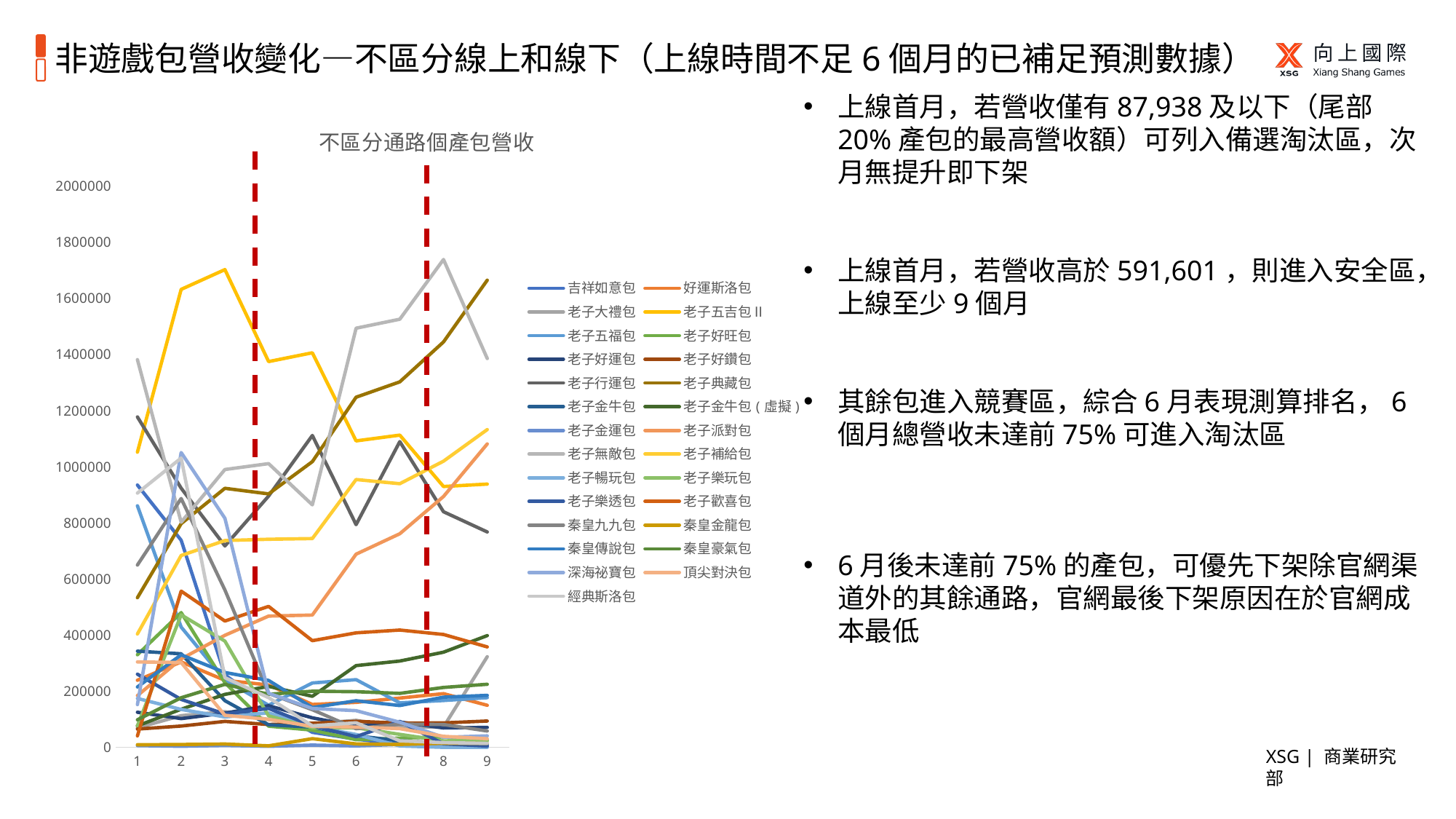
Is the highest value plotted at month 3 greater or less than 1600000? greater How many points are on the x axis of the chart? 9 How many series does the chart's legend list? 27 What is the maximum value shown on the chart's y axis? 2000000 Is the highest value plotted at month 9 greater or less than 1400000? greater Is the highest value plotted at month 5 greater or less than 1600000? less What kind of chart is shown on the slide? line chart What is the title of the chart? 不區分通路個產包營收